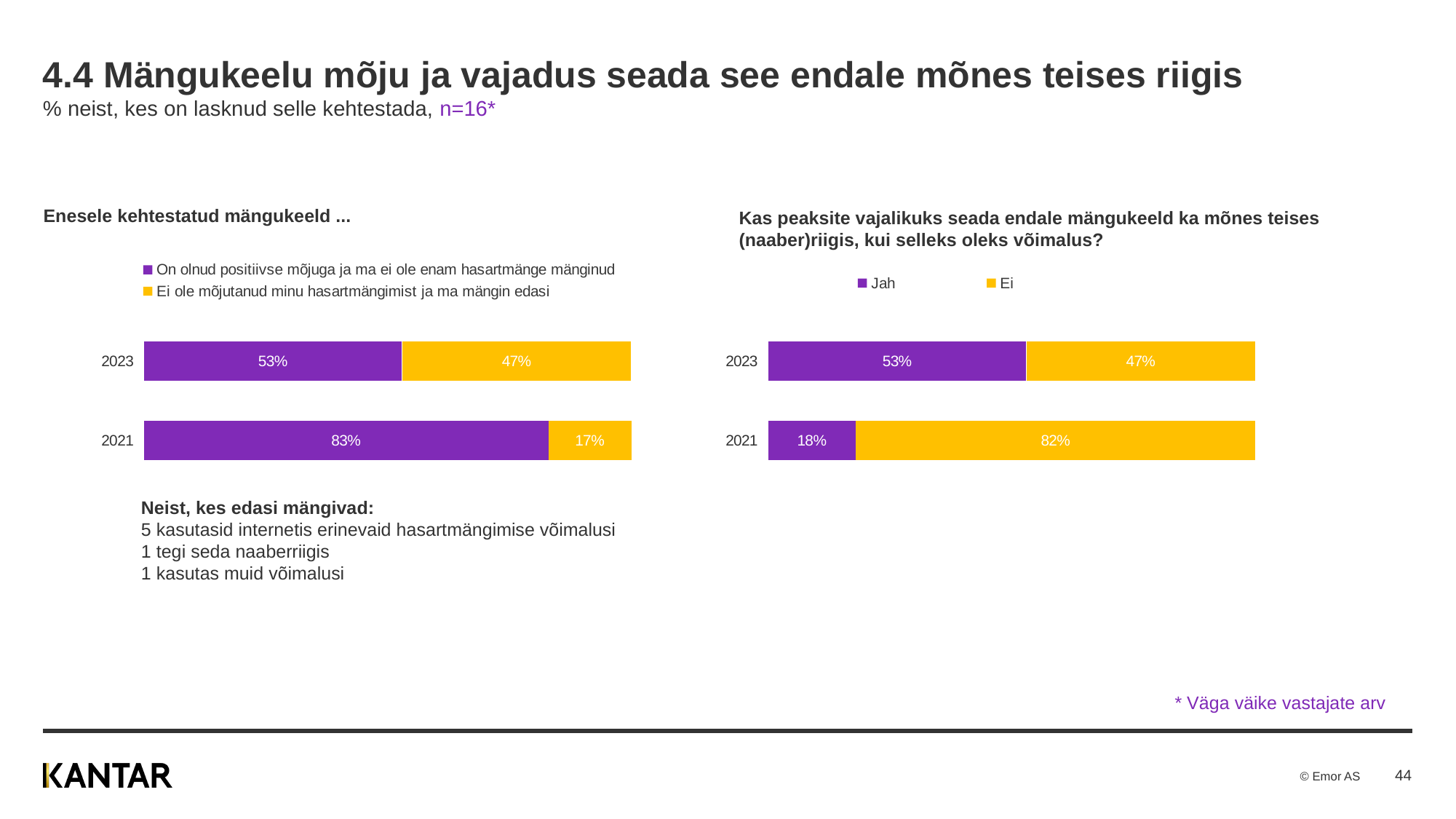
How many years (categories) are shown in the left chart ("Enesele kehtestatud mängukeeld ...")? 2 In the right chart ("Kas peaksite vajalikuks seada endale mängukeeld ka mõnes teises (naaber)riigis..."), what is the value for "Jah" in 2021? 18% What kind of chart is the left chart ("Enesele kehtestatud mängukeeld ...")? Stacked bar chart In the right chart ("Kas peaksite vajalikuks seada endale mängukeeld ka mõnes teises (naaber)riigis..."), which year has the higher "Jah" value, 2021 or 2023? 2023 In the left chart ("Enesele kehtestatud mängukeeld ..."), what is the value for "Ei ole mõjutanud minu hasartmängimist ja ma mängin edasi" in 2021? 17% In the right chart ("Kas peaksite vajalikuks seada endale mängukeeld ka mõnes teises (naaber)riigis..."), what is the total of the stacked bar for 2021? 100% How many series does the legend of the right chart ("Kas peaksite vajalikuks seada endale mängukeeld ka mõnes teises (naaber)riigis...") list? 2 In the left chart ("Enesele kehtestatud mängukeeld ..."), which year has the higher "Ei ole mõjutanud minu hasartmängimist ja ma mängin edasi" value? 2023 In the left chart ("Enesele kehtestatud mängukeeld ..."), what is the difference between the "On olnud positiivse mõjuga..." values for 2021 and 2023? 30 percentage points In the right chart ("Kas peaksite vajalikuks seada endale mängukeeld ka mõnes teises (naaber)riigis..."), what is the value for "Ei" in 2023? 47% In the left chart ("Enesele kehtestatud mängukeeld ..."), what is the value for "On olnud positiivse mõjuga ja ma ei ole enam hasartmänge mänginud" in 2023? 53% In the right chart ("Kas peaksite vajalikuks seada endale mängukeeld ka mõnes teises (naaber)riigis..."), what is the difference between the "Ei" values for 2021 and 2023? 35 percentage points